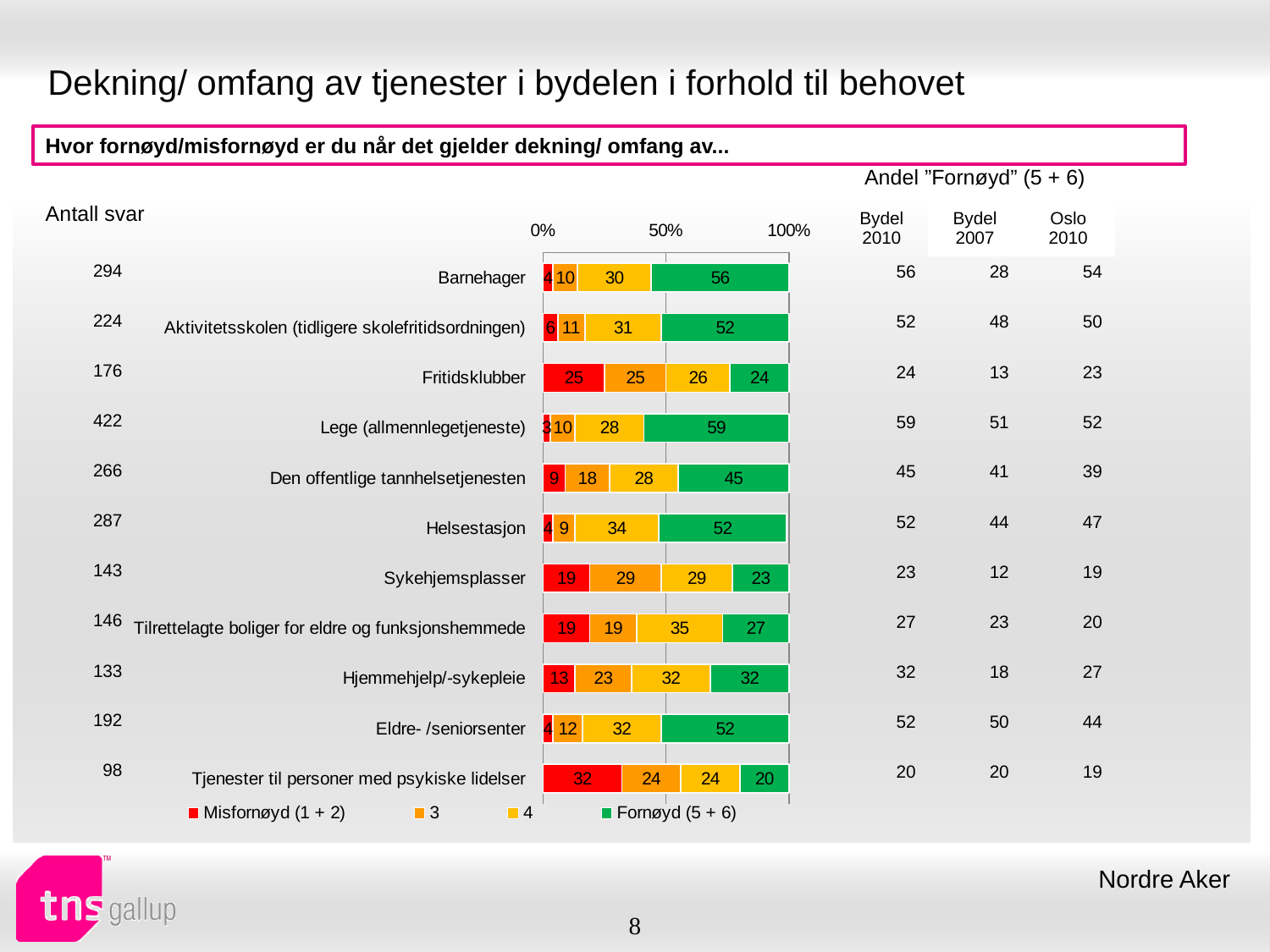
How many series does the legend list? 4 What kind of chart is shown on the slide? Stacked bar chart Which category has the highest "Fornøyd (5 + 6)" value? Lege (allmennlegetjeneste) Which has the larger "Misfornøyd (1 + 2)" value, Sykehjemsplasser or Hjemmehjelp/-sykepleie? Sykehjemsplasser What colour represents the "Fornøyd (5 + 6)" series in the legend? Green What is the value of the "Misfornøyd (1 + 2)" series for Tjenester til personer med psykiske lidelser? 32 Which category has the lowest "Fornøyd (5 + 6)" value? Tjenester til personer med psykiske lidelser What is the value of the "4" series for Tilrettelagte boliger for eldre og funksjonshemmede? 35 What is the difference between the "Fornøyd (5 + 6)" values for Barnehager and Fritidsklubber? 32 What is the total of the stacked bar for Fritidsklubber? 100 How many categories are shown in the bar chart? 11 What is the value of the "Fornøyd (5 + 6)" series for Lege (allmennlegetjeneste)? 59